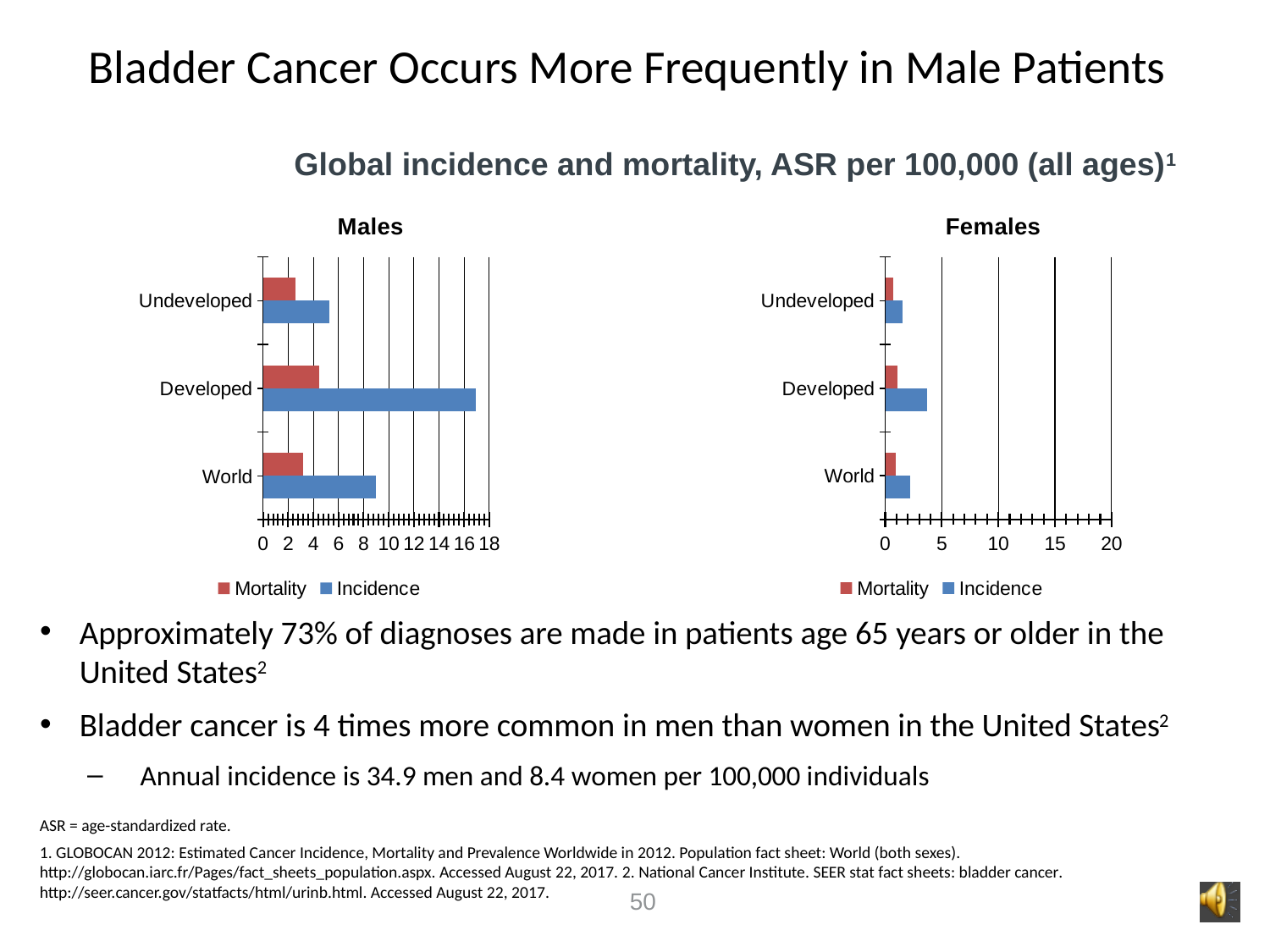
In the Females chart, is the incidence for Developed greater or less than 5? less What is the overall title above the two charts? Global incidence and mortality, ASR per 100,000 (all ages) What kind of chart is the Males chart? bar chart In the Males chart, is the mortality for Undeveloped greater or less than 4? less In the Males chart, is the incidence for World greater or less than 8? greater In the Males chart, which category has the highest incidence? Developed How many series does the legend of the Females chart list? 2 In the Females chart, which category has the highest incidence? Developed How many categories are shown on the Males chart? 3 In the Males chart, which is larger for Developed: Mortality or Incidence? Incidence In the Males chart, which category has the lowest incidence? Undeveloped